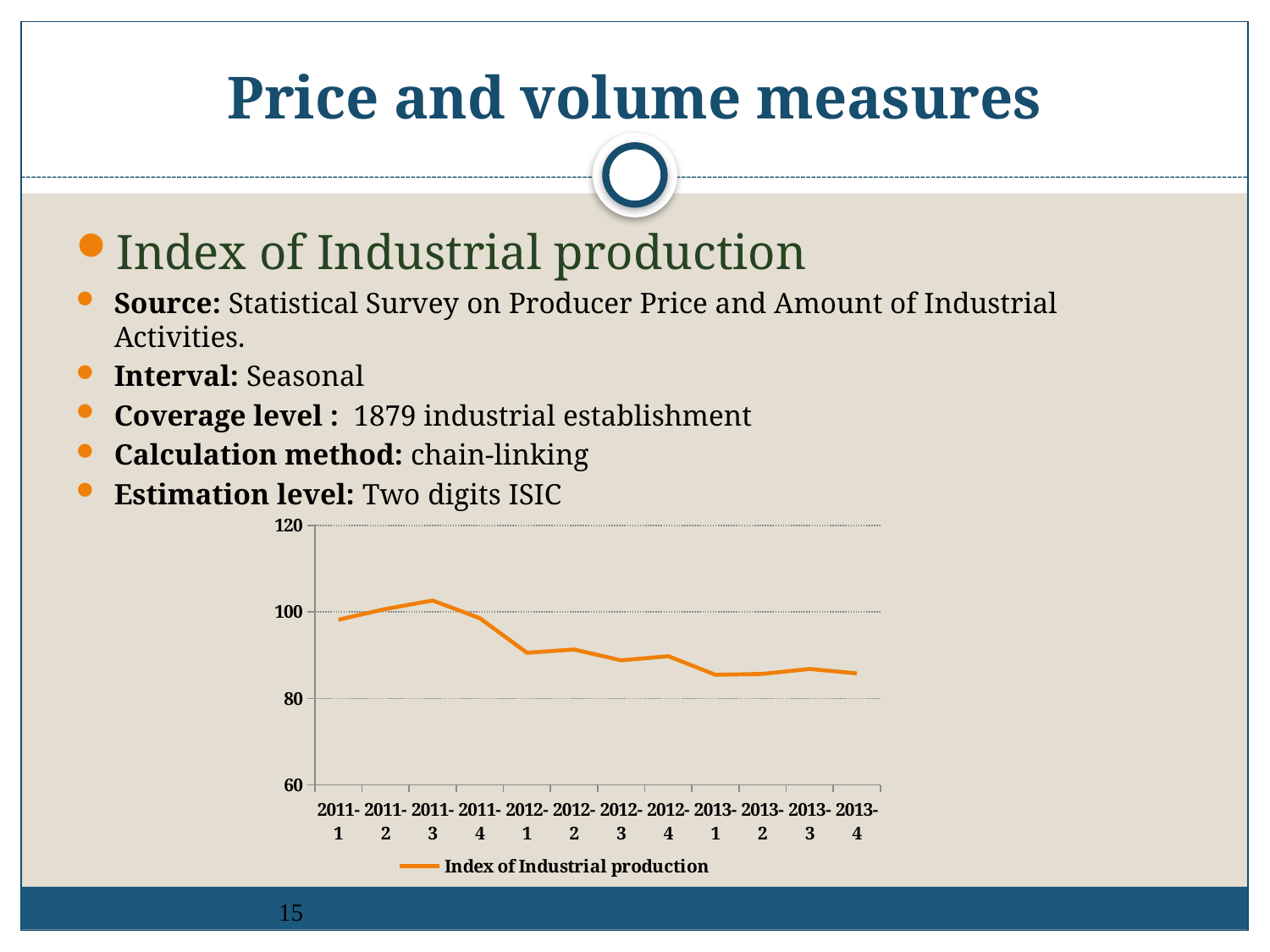
Is the value for 2012-3 greater or less than 100? less Which is larger, the value for 2011-2 or the value for 2012-2? 2011-2 Overall, does the Index of Industrial production rise or fall from 2011-1 to 2013-4? fall How many series does the chart legend list? 1 Is the value for 2011-3 greater or less than 100? greater Which is larger, the value for 2011-3 or the value for 2013-1? 2011-3 What kind of chart is shown on the slide? line chart Is the value for 2012-1 greater or less than 100? less Which period has the highest value of the Index of Industrial production? 2011-3 How many data points are plotted along the x axis of the chart? 12 What is the name of the series shown in the chart legend? Index of Industrial production